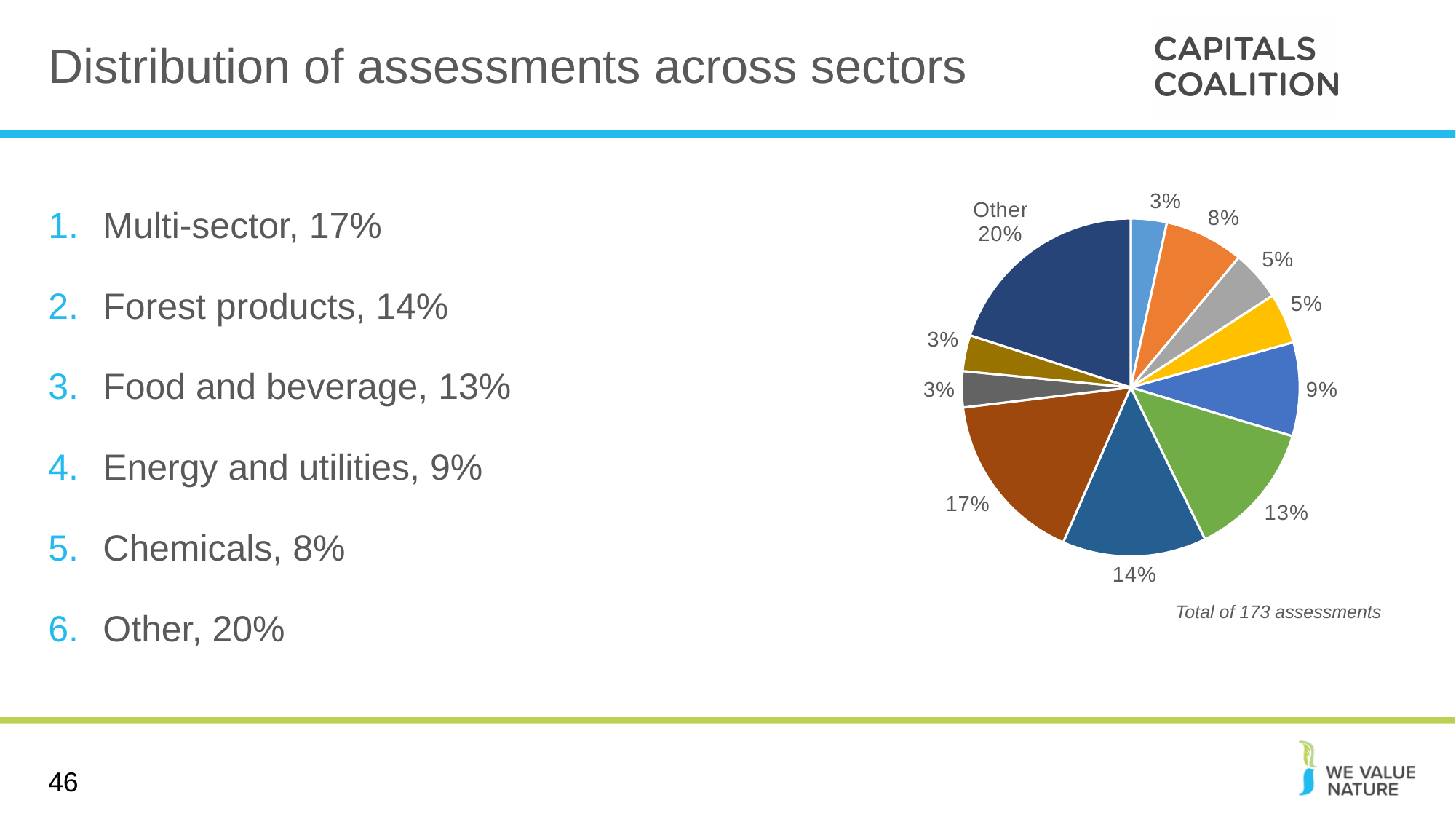
What is the total number of assessments noted below the pie chart? 173 What kind of chart is shown on the slide? pie chart What is the smallest percentage shown on any slice of the pie chart? 3% What is the difference between the 'Other' slice (20%) and the 17% slice? 3% According to the slide, what share of assessments is Multi-sector? 17% How many slices does the pie chart have? 11 Which is larger, the 14% slice or the 13% slice? the 14% slice How many slices of the pie chart are labelled 3%? 3 What is the title of the slide containing the pie chart? Distribution of assessments across sectors Which slice of the pie chart is the largest? Other According to the slide, what share of assessments is Forest products? 14% What share of the pie does the 'Other' slice represent? 20%